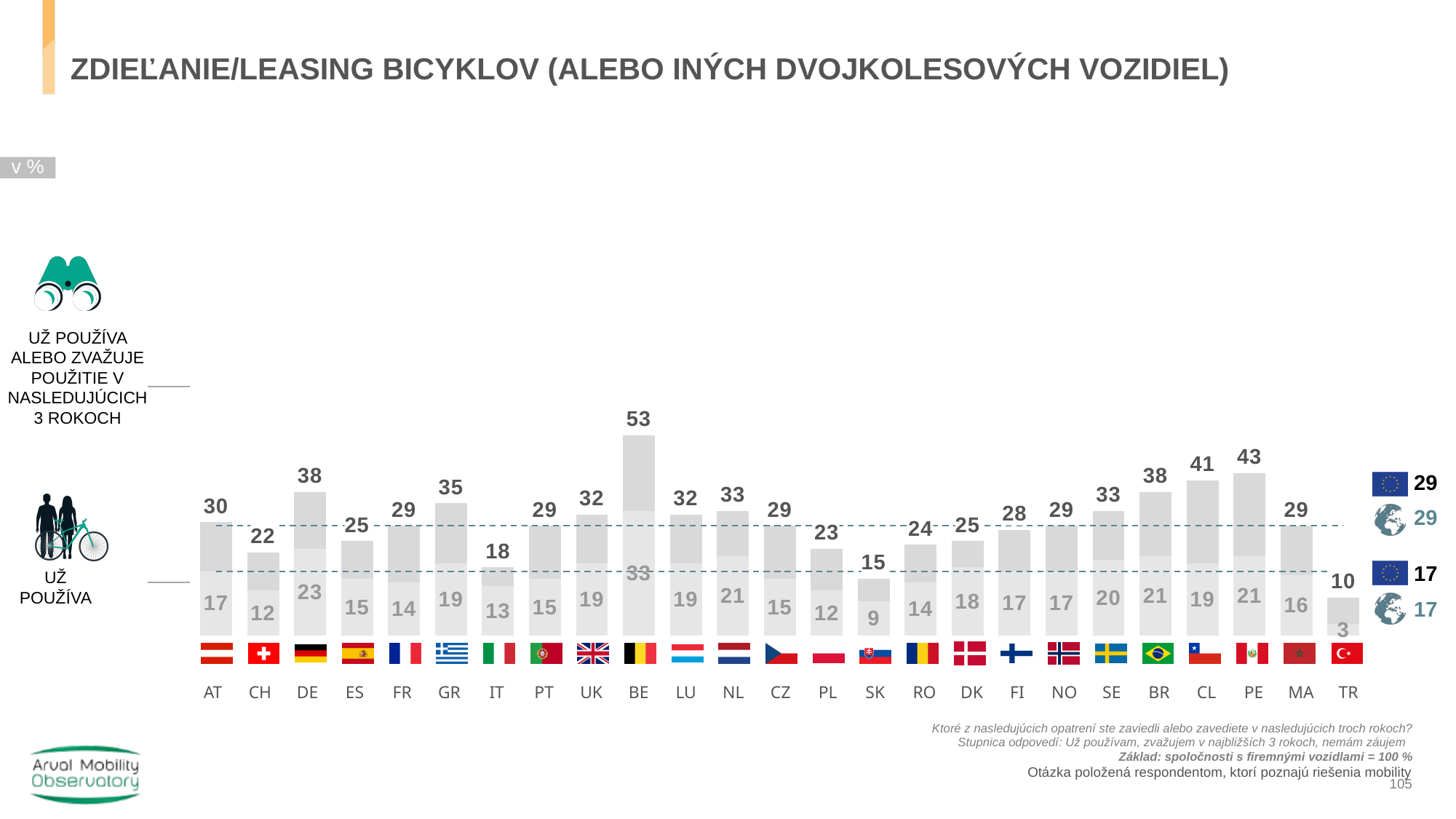
Which country has the lowest 'Už používa' value? TR Which has a higher 'Už používa' value, SE or NL? NL What is the EU value shown for 'Už používa' on the right side of the chart? 17 What is the difference between the 'Už používa alebo zvažuje' value and the 'Už používa' value for BE? 20 Which country has the lowest value for 'Už používa alebo zvažuje použitie v nasledujúcich 3 rokoch'? TR What is the difference between the 'Už používa alebo zvažuje' value for PE and for CL? 2 What is the 'Už používa' value for TR? 3 What is the value for BE for 'Už používa alebo zvažuje použitie v nasledujúcich 3 rokoch'? 53 What is the 'Už používa' value for DE? 23 Which country has the highest value for 'Už používa alebo zvažuje použitie v nasledujúcich 3 rokoch'? BE What kind of chart is shown on the slide? Bar chart How many countries are shown on the x axis of the chart? 25